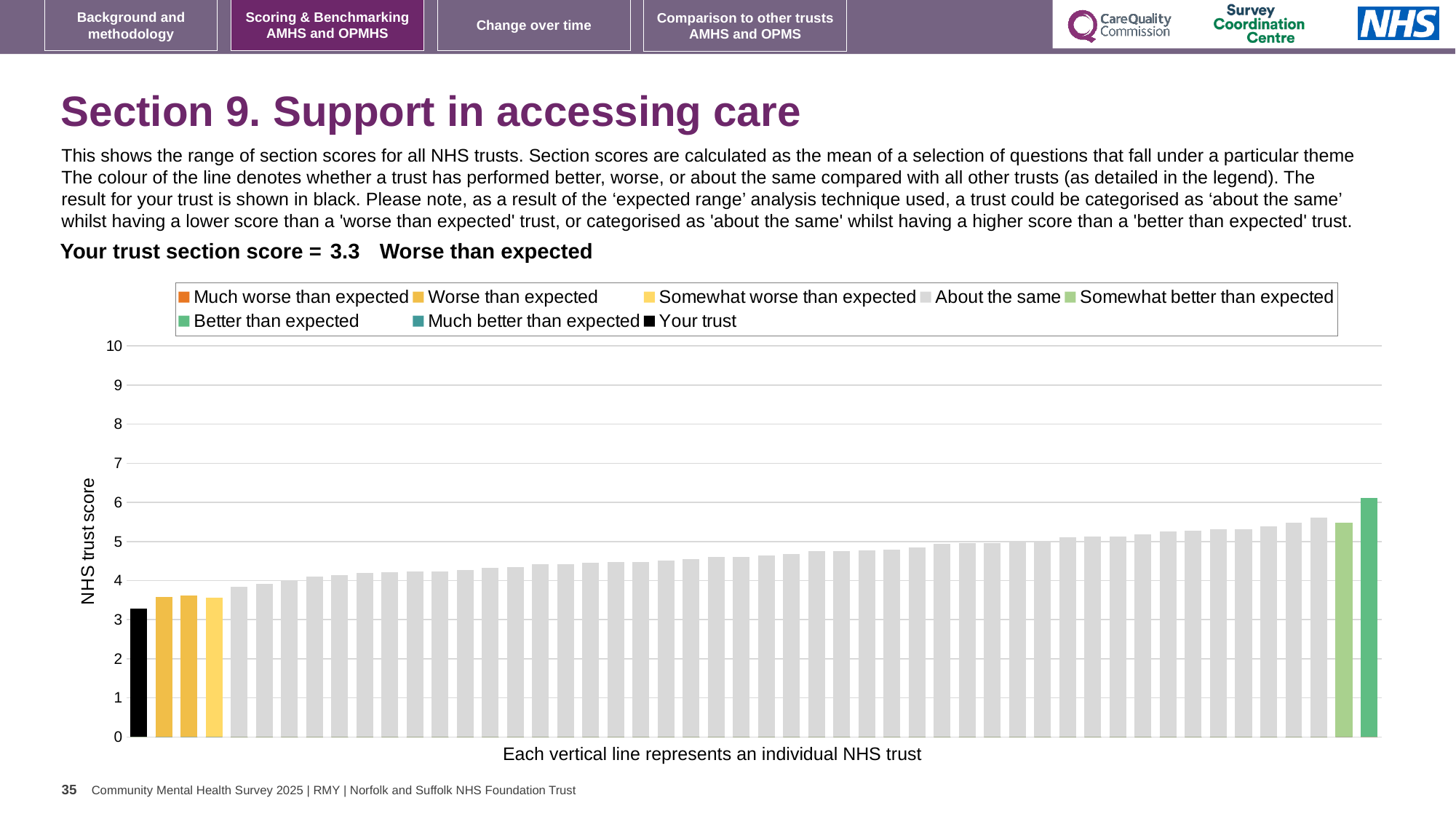
Do the bar values rise or fall from left to right along the x axis? rise Which bar has the lowest value on the chart? Your trust (the black bar) How many entries does the chart legend list? 8 How many bars are shown in yellow on the chart? 3 Which of the two is larger: the black bar for your trust or the green bar at the far right? the green bar at the far right Is the value of the tallest bar greater or less than 5? greater Which category is your trust placed in for this section? Worse than expected Is the value of the light green (Somewhat better than expected) bar greater or less than 5? greater Is the value for your trust (the black bar) greater or less than 4? less What kind of chart is shown on the slide? bar chart What is the section score for your trust? 3.3 What is the label on the vertical axis of the chart? NHS trust score